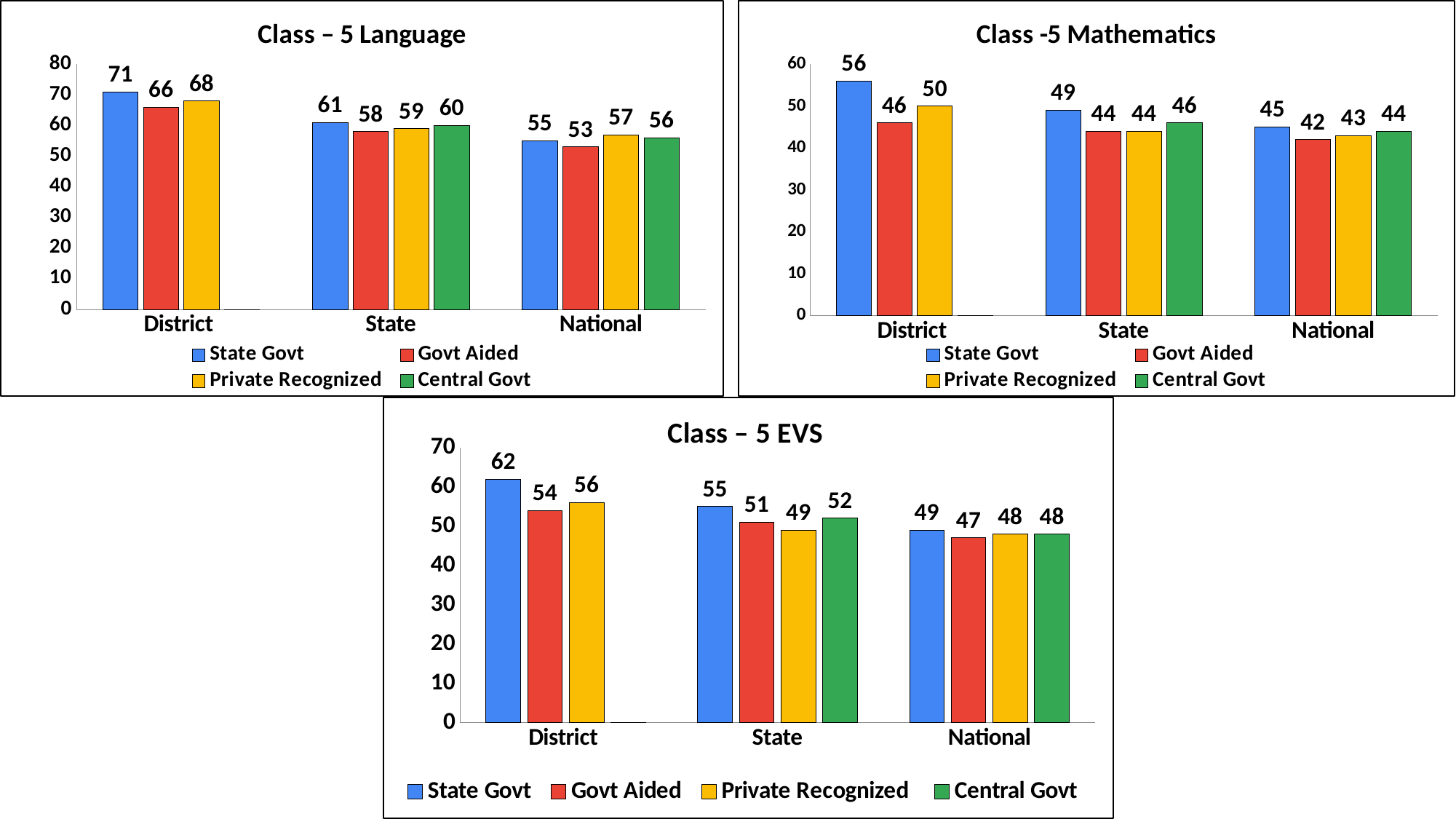
What kind of chart is the Class -5 Mathematics chart? Bar chart In the Class – 5 EVS chart, which colour represents Central Govt? Green In the Class -5 Mathematics chart, which series has the lowest value in the District category? Govt Aided In the Class -5 Mathematics chart, which is larger: State Govt in the State category or State Govt in the National category? State Govt in the State category In the Class – 5 EVS chart, what is the value for Central Govt in the State category? 52 In the Class – 5 Language chart, which series has the highest value in the National category? Private Recognized In the Class – 5 Language chart, what is the value for State Govt in the District category? 71 In the Class – 5 EVS chart, what is the difference between the State Govt and Govt Aided values in the District category? 8 In the Class – 5 Language chart, do the State Govt values rise or fall from District to National? Fall In the Class -5 Mathematics chart, what is the value for Private Recognized in the National category? 43 How many series does the legend of the Class – 5 Language chart list? 4 How many categories are shown on the x axis of the Class – 5 EVS chart? 3